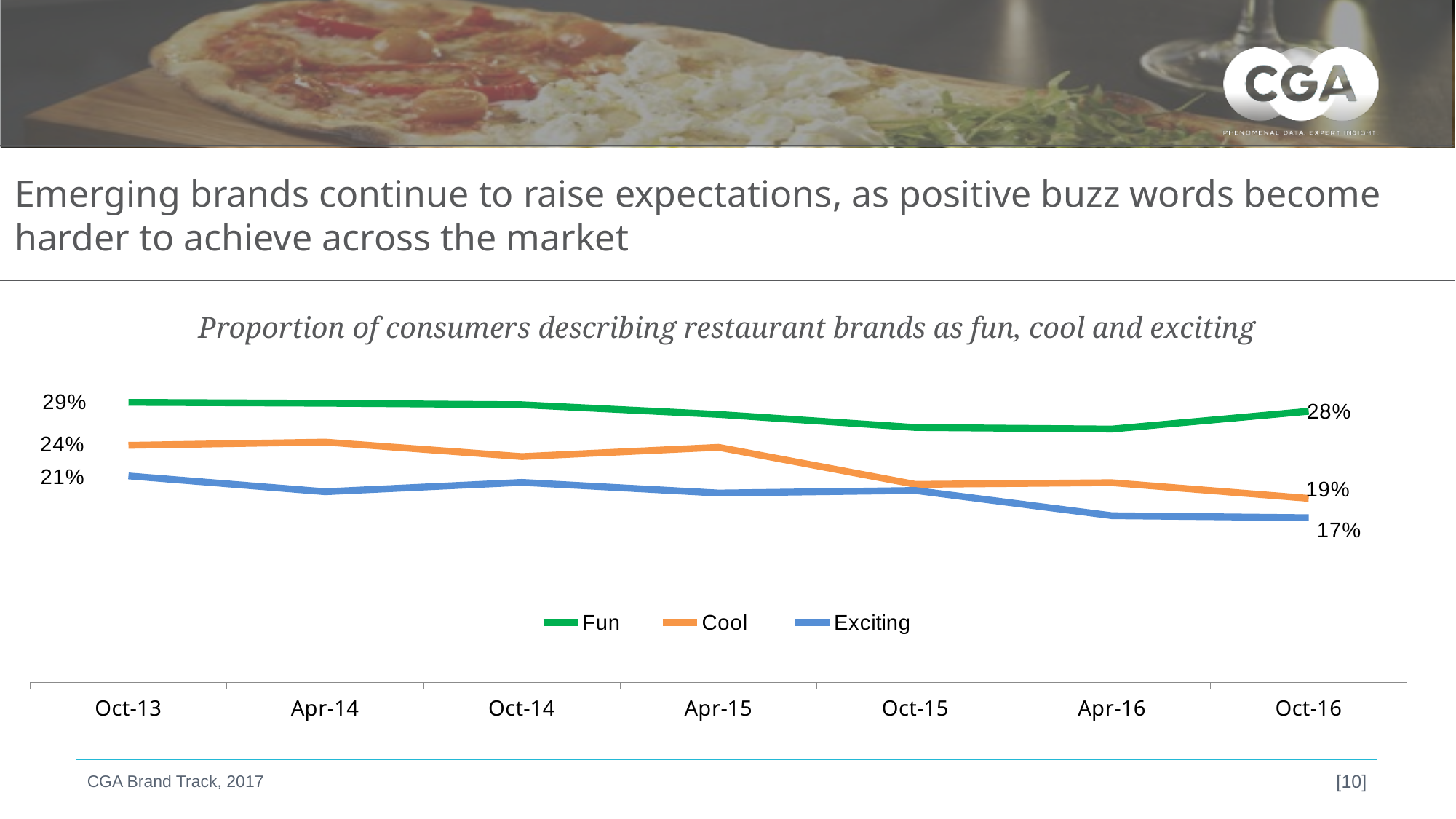
What type of chart is shown on the slide? line chart Does the Exciting series rise or fall from Oct-13 to Oct-16? fall What is the value for Cool at Oct-16? 19% How many time points are shown on the x axis? 7 Which series has the highest value at Oct-16? Fun What is the value for Exciting at Oct-16? 17% What is the difference between the Cool value at Oct-13 and at Oct-16? 5% What is the title of the chart? Proportion of consumers describing restaurant brands as fun, cool and exciting What is the value for Cool at Oct-13? 24% How many series does the legend list? 3 What is the value for Fun at Oct-13? 29% Which series has the lowest value at Oct-13? Exciting